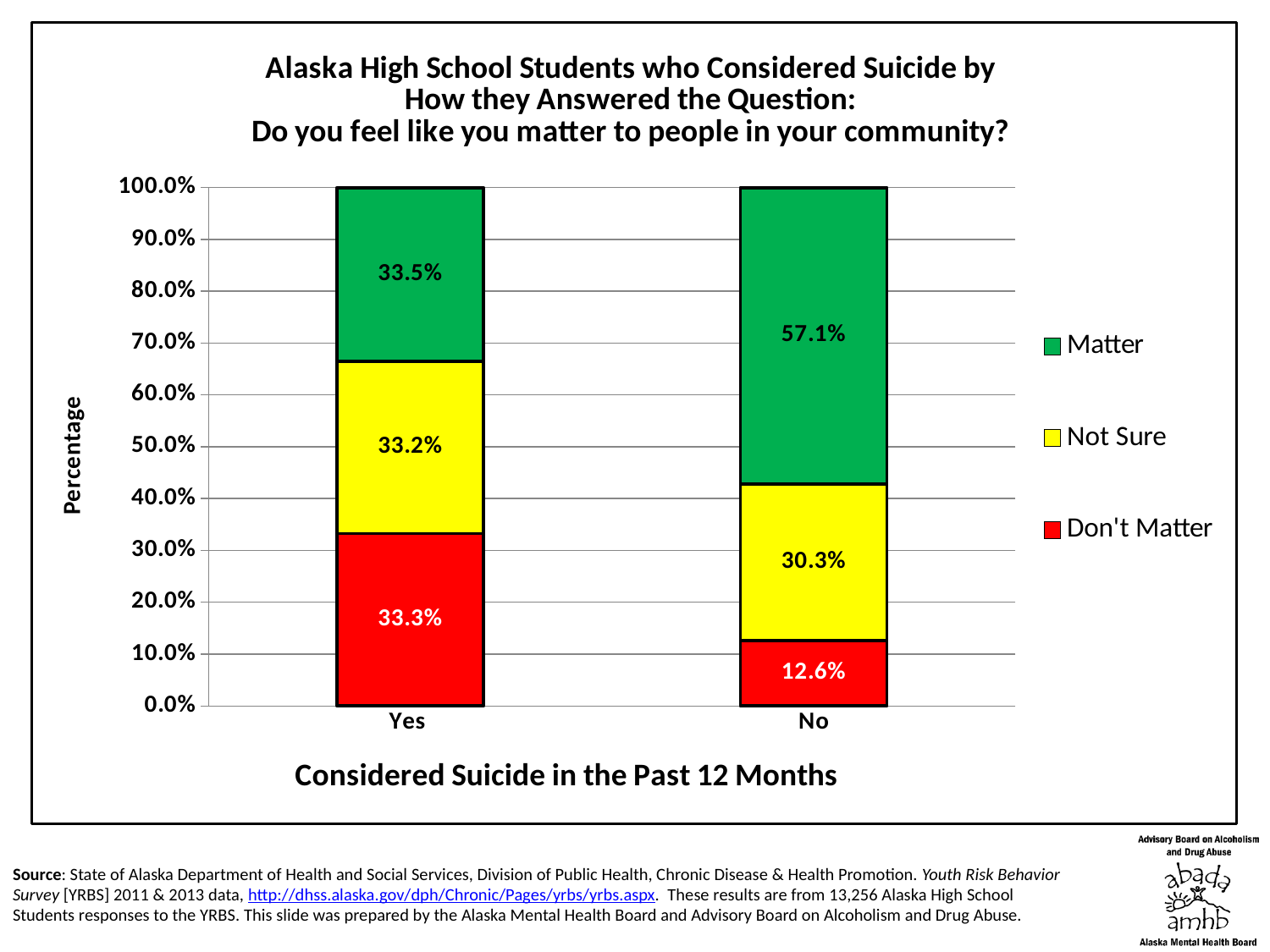
What kind of chart is shown on the slide? Stacked bar chart Which category has the lower "Don't Matter" value? No What is the "Don't Matter" value for the "Yes" bar? 33.3% How many categories are shown on the x axis? 2 What is the "Not Sure" value for the "No" bar? 30.3% What is the difference between the "Don't Matter" values for "Yes" and "No"? 20.7% How many series does the legend list? 3 What colour represents the "Not Sure" series? Yellow What is the difference between the "Matter" values for "No" and "Yes"? 23.6% What percentage of students who answered "No" to considering suicide said they "Don't Matter"? 12.6% What percentage of students who answered "Yes" to considering suicide said they "Matter"? 33.5% Which category has the higher "Matter" value, "Yes" or "No"? No